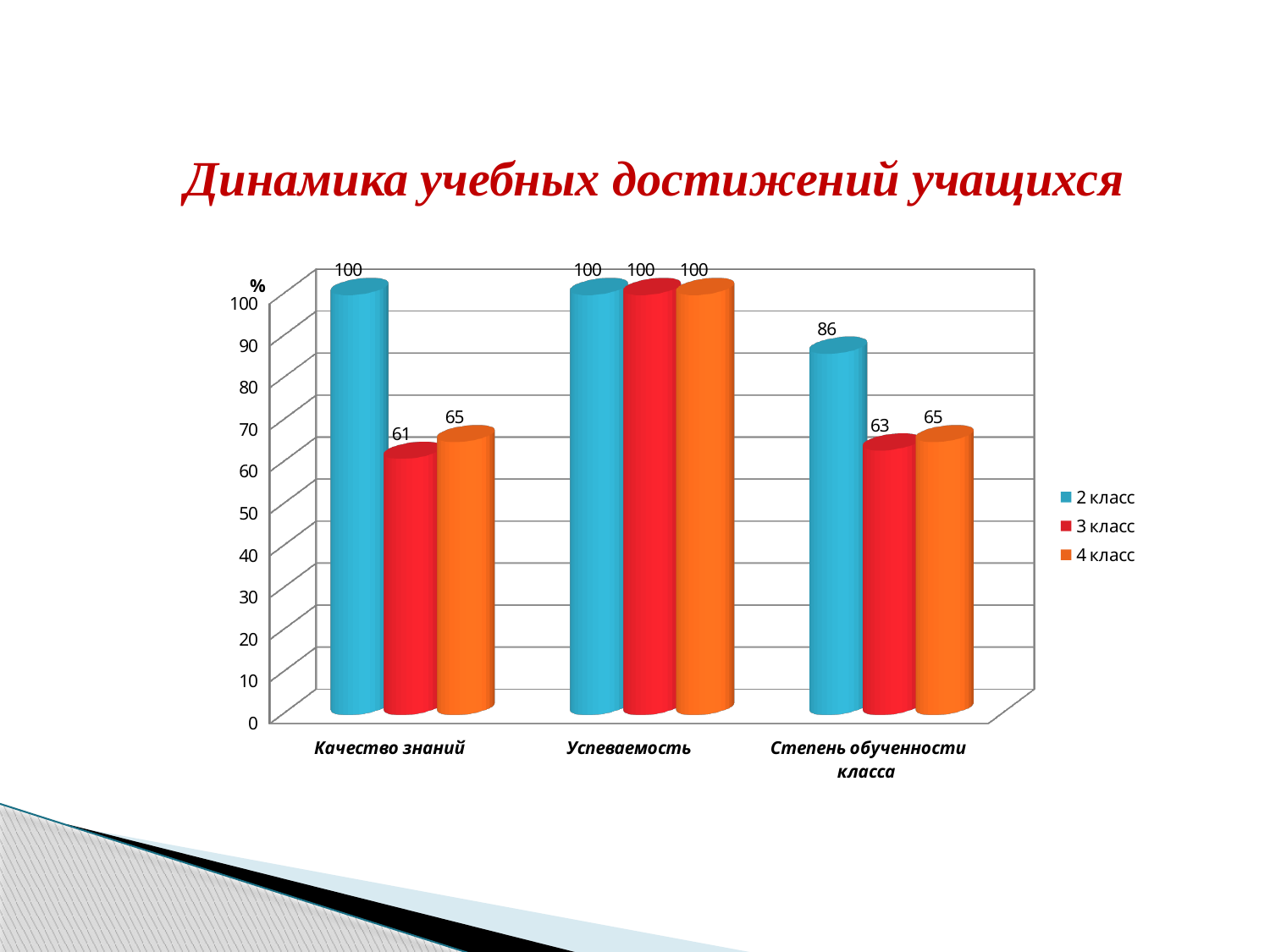
What kind of chart is shown on the slide? Bar chart Which is larger: the 2 класс value for Степень обученности класса or the 4 класс value for Степень обученности класса? 2 класс Which series has the highest value in the Степень обученности класса category? 2 класс What is the title of the slide? Динамика учебных достижений учащихся What is the difference between the 2 класс and 3 класс values in the Качество знаний category? 39 How many series does the legend list? 3 Which series has the lowest value in the Качество знаний category? 3 класс What is the value for 2 класс in the Качество знаний category? 100 What is the difference between the 4 класс and 3 класс values in the Степень обученности класса category? 2 What is the value for 4 класс in the Качество знаний category? 65 What is the value for 3 класс in the Степень обученности класса category? 63 How many categories are shown on the x axis? 3